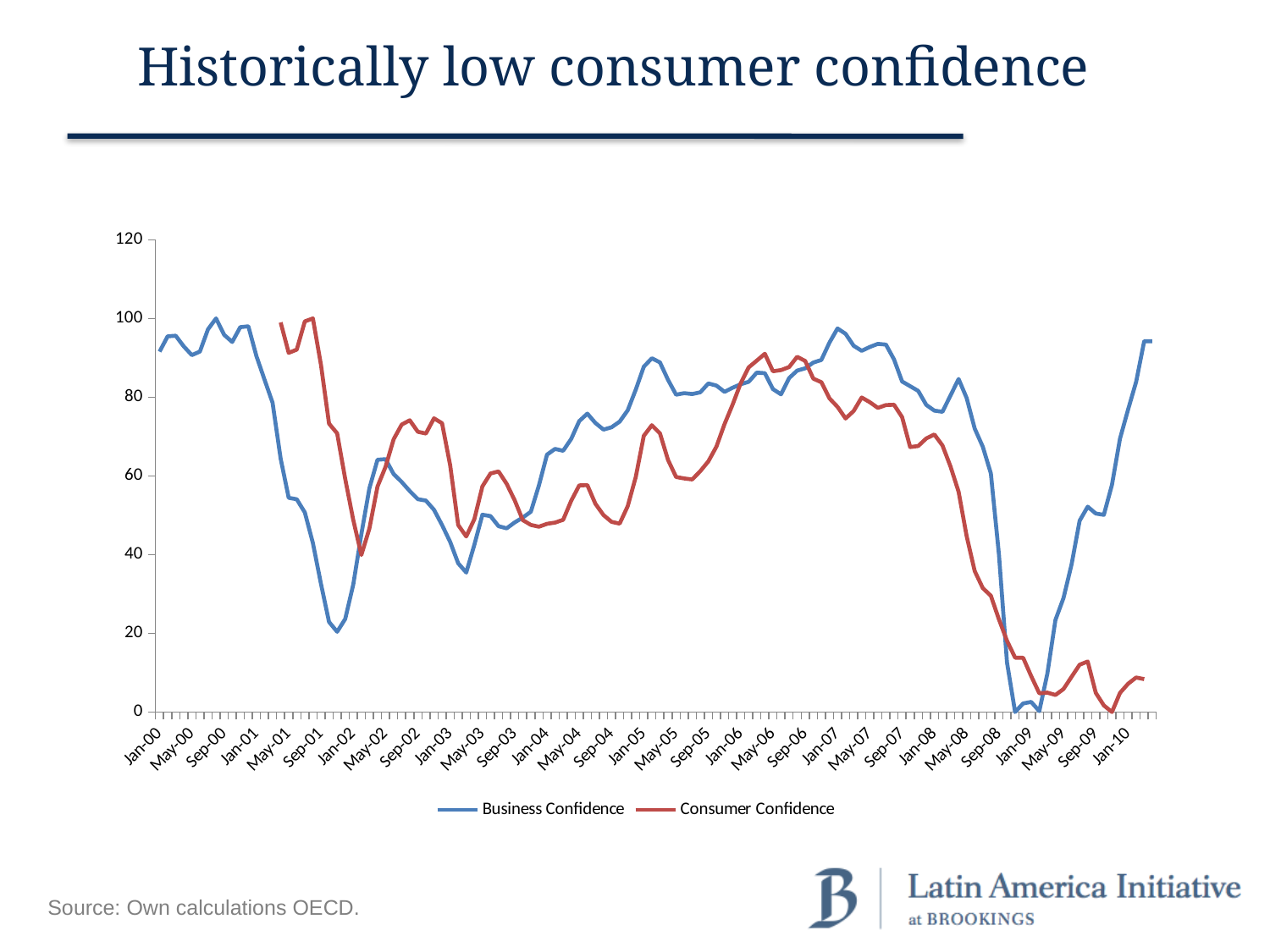
Which colour is used for the Consumer Confidence line? Red Is the value of Business Confidence at Jan-09 greater or less than 20? less Does Consumer Confidence rise or fall between Jan-08 and Jan-09? Fall Is the value of Consumer Confidence at May-01 greater or less than 80? greater At Jan-07, which series has the higher value, Business Confidence or Consumer Confidence? Business Confidence Does Business Confidence rise or fall between Jan-07 and Jan-09? Fall Is the value of Consumer Confidence at Jan-09 greater or less than 40? less How many series does the legend list? 2 At Jan-05, which series has the higher value, Business Confidence or Consumer Confidence? Business Confidence What kind of chart is shown on the slide? Line chart What is the title of the slide? Historically low consumer confidence